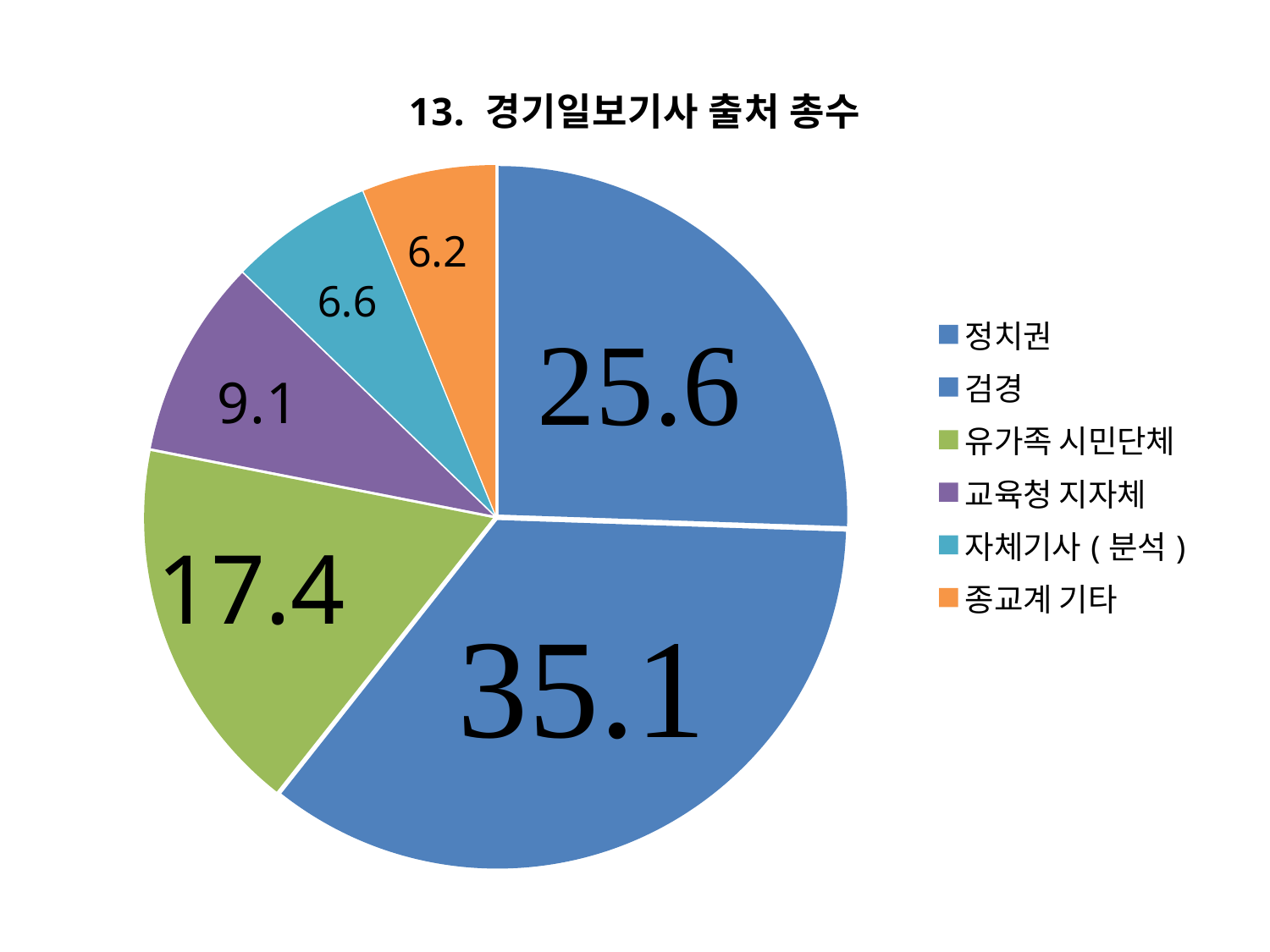
What is the value for 검경? 35.1 What colour is the slice for 자체기사 ( 분석 )? teal What is the value for 유가족 시민단체? 17.4 What is the value for 종교계 기타? 6.2 Which category has the smallest slice? 종교계 기타 How many categories does the pie chart have? 6 What is the value for 교육청 지자체? 9.1 Which is larger, the value for 유가족 시민단체 or the value for 교육청 지자체? 유가족 시민단체 What is the title of the chart? 13. 경기일보기사 출처 총수 Which category has the largest slice? 검경 What is the difference between the values for 검경 and 정치권? 9.5 What type of chart is shown on the slide? pie chart